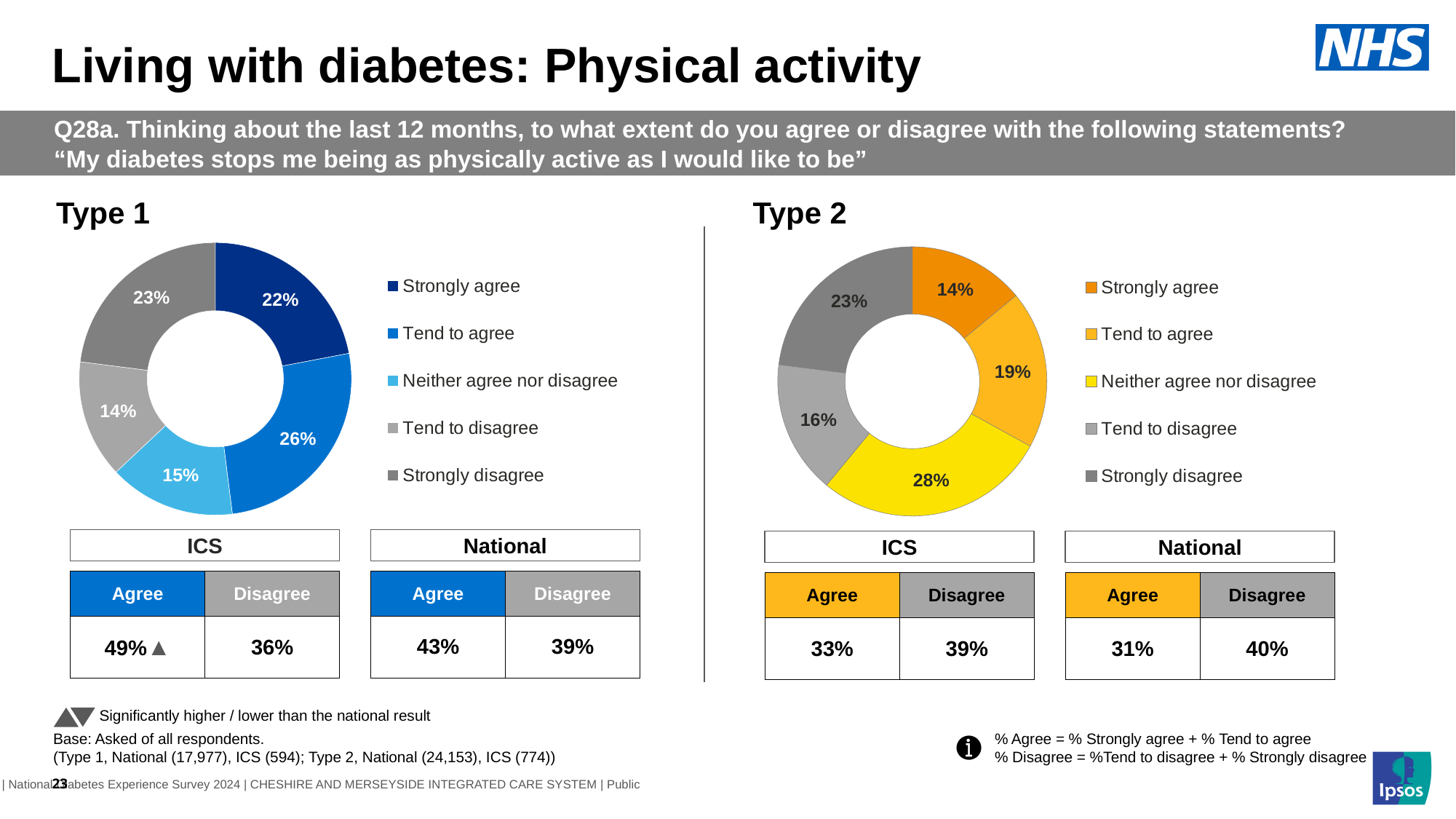
In the Type 2 chart, which is larger: 'Tend to agree' or 'Tend to disagree'? Tend to agree In the Type 2 chart, what percentage of respondents said 'Neither agree nor disagree'? 28% What kind of chart is used for Type 2? Donut chart In the Type 2 chart, which response category has the largest share? Neither agree nor disagree In the Type 2 chart, what percentage of respondents said 'Strongly agree'? 14% In the Type 1 chart, which response category has the largest share? Tend to agree In the Type 1 chart, what percentage of respondents said 'Strongly agree'? 22% In the Type 2 chart, what colour represents 'Neither agree nor disagree'? Yellow In the Type 1 chart, what percentage of respondents said 'Tend to disagree'? 14% In the Type 1 chart, what is the difference between the 'Tend to agree' and 'Neither agree nor disagree' shares? 11% In the Type 2 chart, which response category has the smallest share? Strongly agree How many response categories does the Type 1 chart's legend list? 5